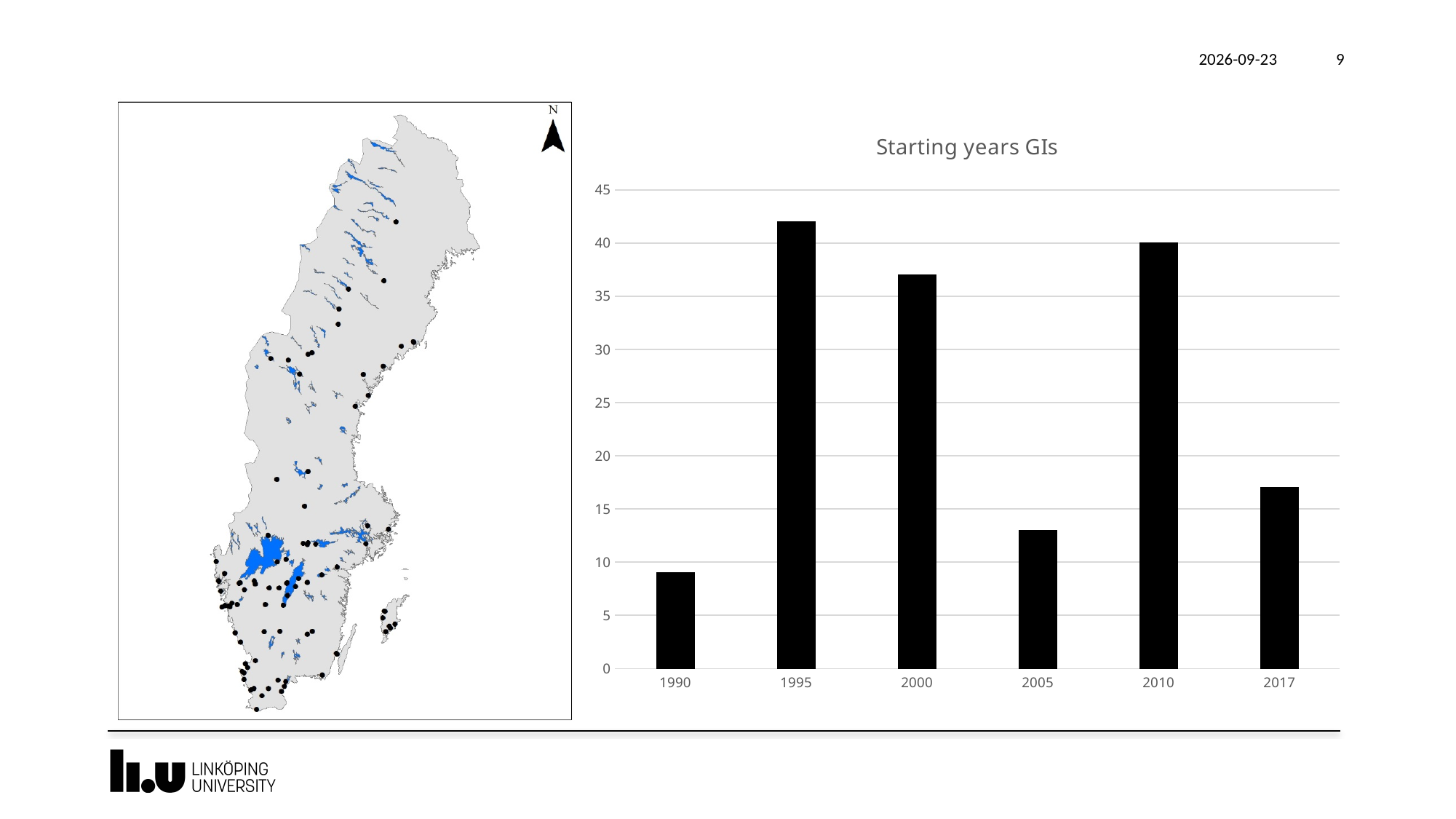
Is the value for 1995 greater or less than 40? greater Is the value for 2017 greater or less than 20? less How many categories (years) are shown on the x axis of the chart? 6 What is the title of the chart? Starting years GIs Which year has the highest bar in the chart? 1995 What type of chart is shown on the slide? bar chart Which has the larger value, 2017 or 1990? 2017 Is the value for 2005 greater or less than 15? less Which has the larger value, 2000 or 2005? 2000 Which year has the lowest bar in the chart? 1990